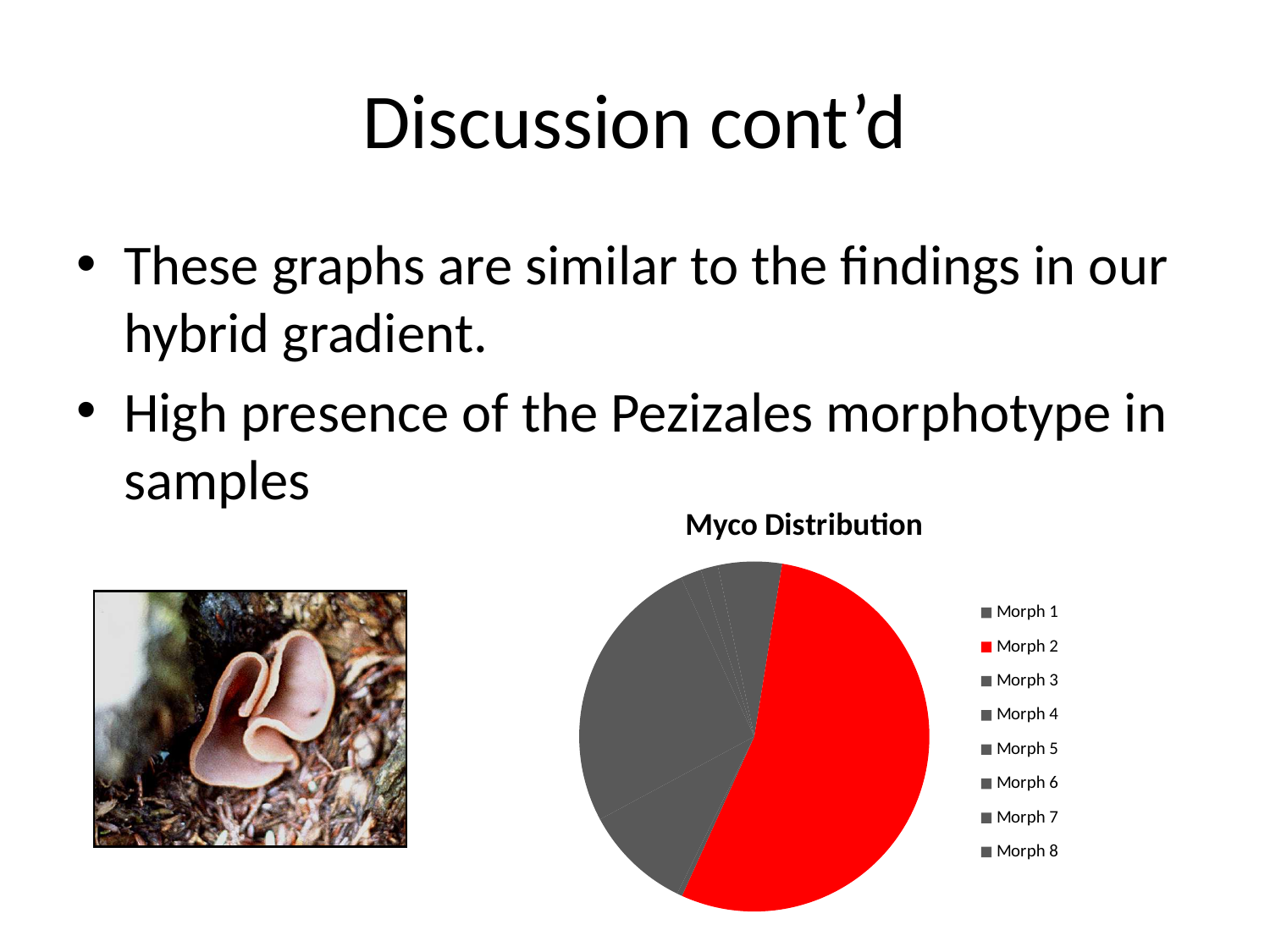
What is the label of the first entry in the legend of the Myco Distribution chart? Morph 1 How many categories does the legend of the Myco Distribution chart list? 8 In the Myco Distribution chart, which is larger: the Morph 2 slice or the combined area of all the other slices? Morph 2 What kind of chart is shown on the slide? pie chart What colour is the Morph 2 slice in the Myco Distribution chart? red What is the title of the chart on the slide? Myco Distribution Which category has the largest slice in the Myco Distribution pie chart? Morph 2